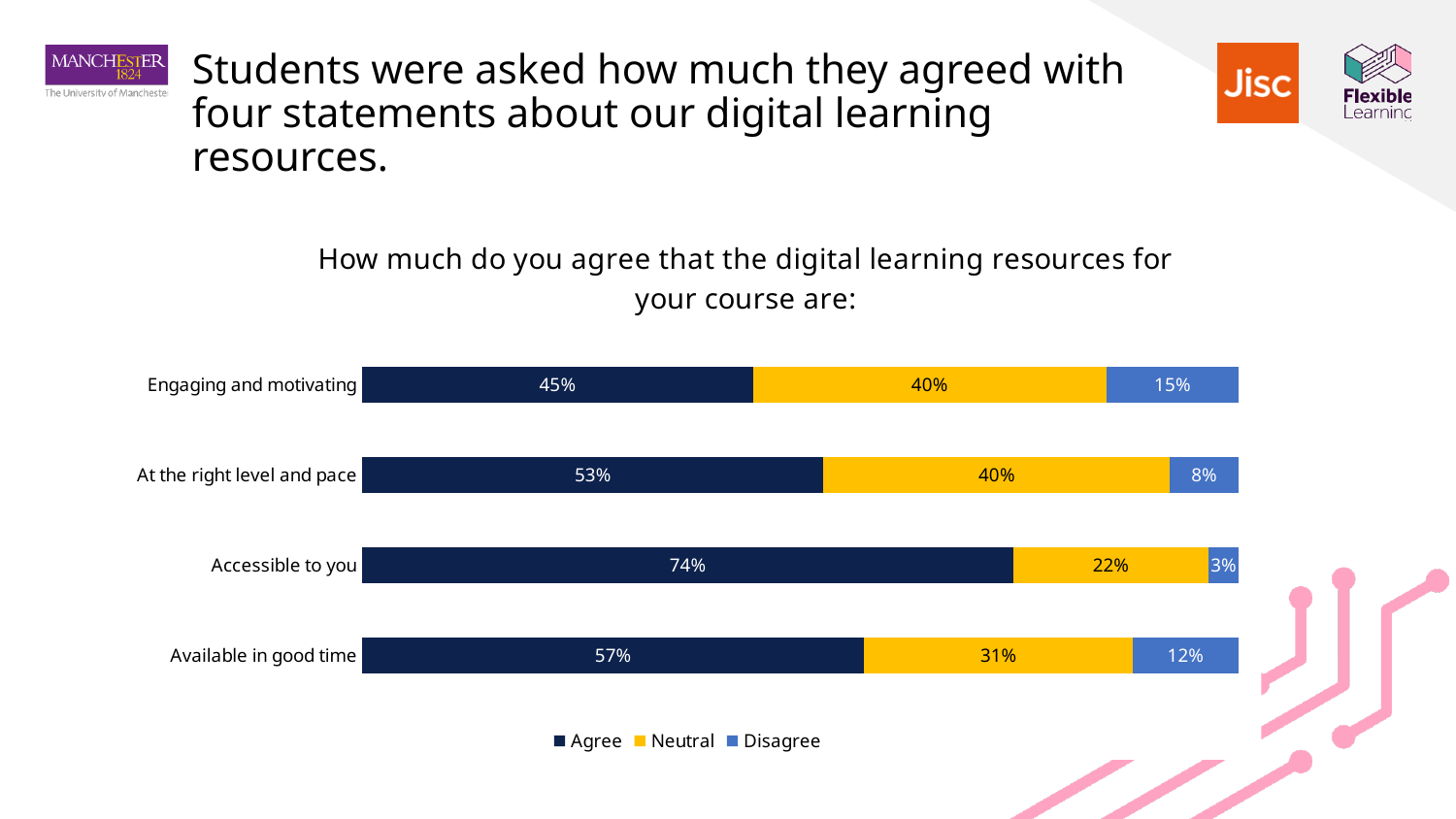
Which statement has the lowest Disagree percentage? Accessible to you Which statement has the highest Agree percentage? Accessible to you How many statements are shown in the chart? 4 How many series does the legend list? 3 What is the Disagree value for 'Engaging and motivating'? 15% What are the three legend entries in the chart? Agree, Neutral, Disagree What kind of chart is shown on the slide? Stacked bar chart What is the total of the stacked bar for 'At the right level and pace'? 101% What is the Neutral value for 'Available in good time'? 31% What percentage of students agreed that the digital learning resources are accessible to them? 74% What is the difference between the Agree percentages for 'Accessible to you' and 'Engaging and motivating'? 29% Which has a larger Agree percentage: 'At the right level and pace' or 'Available in good time'? Available in good time